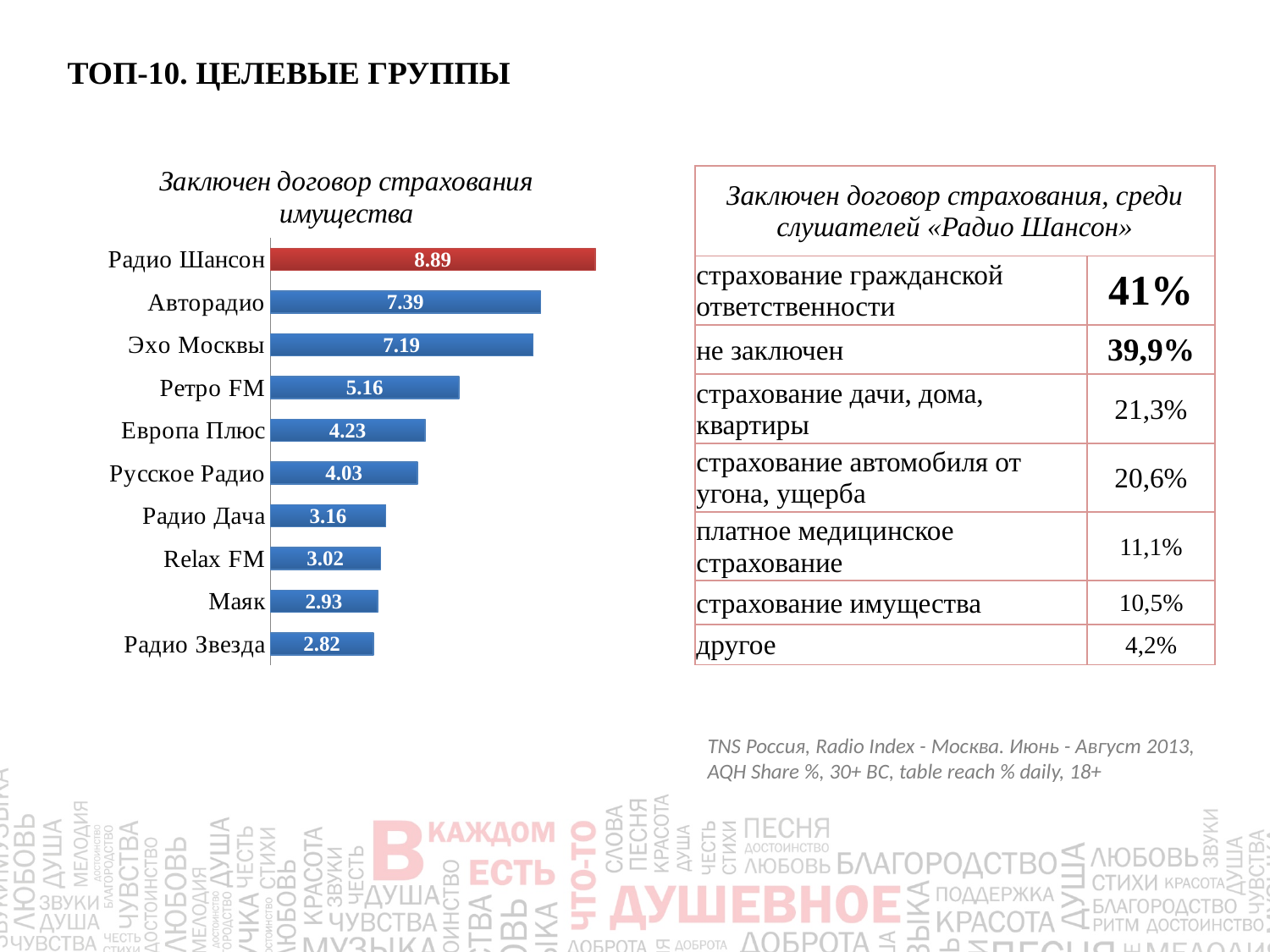
What is the value for Радио Шансон in the chart? 8.89 What is the difference between the values for Европа Плюс and Русское Радио? 0.20 What is the value for Ретро FM in the chart? 5.16 Which is larger, the value for Эхо Москвы or the value for Ретро FM? Эхо Москвы Which radio station has the lowest value in the chart? Радио Звезда How many radio stations are shown in the chart? 10 Which radio station's bar is coloured red in the chart? Радио Шансон What is the difference between the values for Радио Шансон and Авторадио? 1.50 What type of chart is shown on the slide? Bar chart Do the values rise or fall going from the top bar to the bottom bar of the chart? Fall Which radio station has the highest value in the chart? Радио Шансон What is the value for Маяк in the chart? 2.93